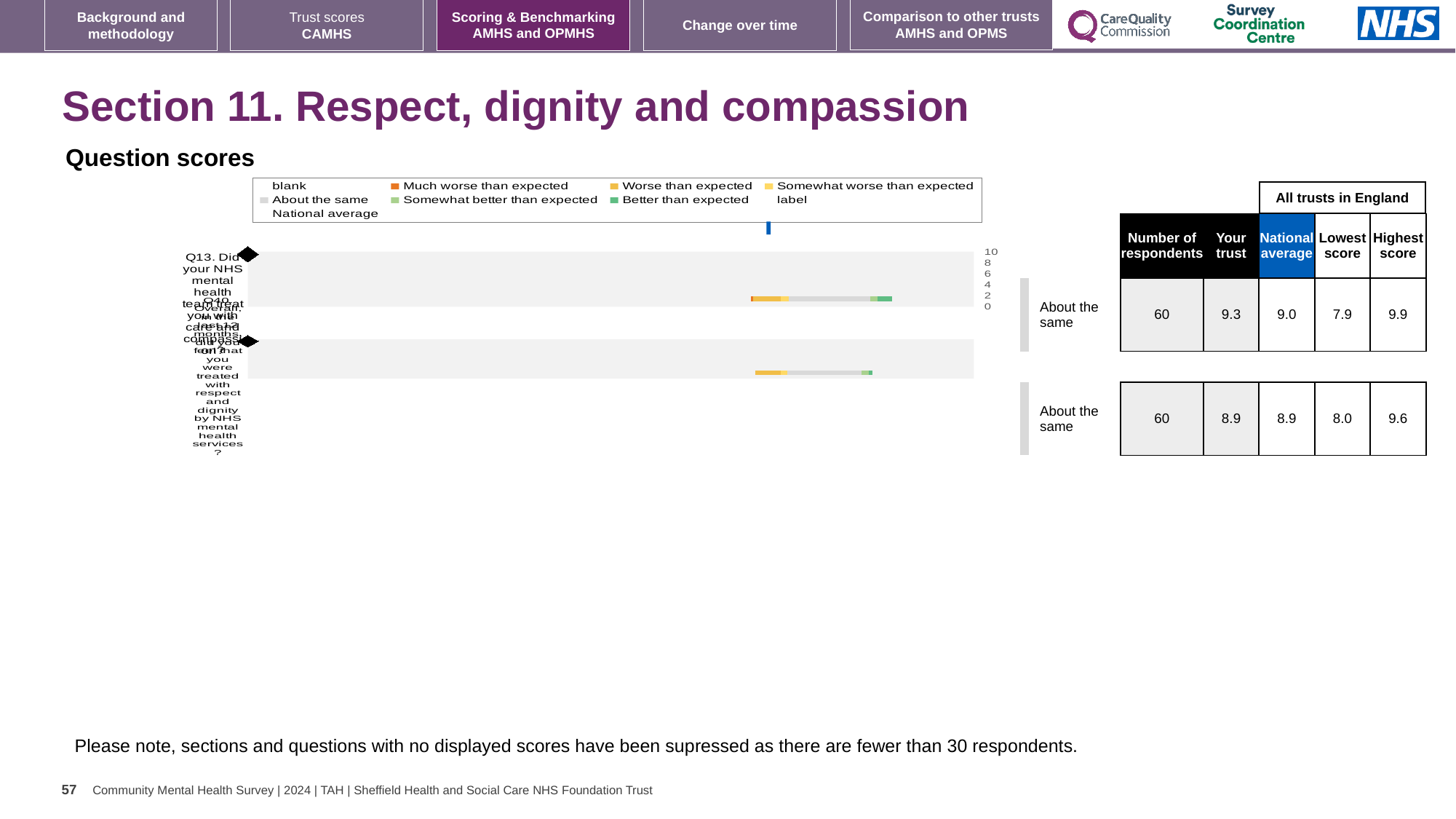
What benchmark category is shown beside both rows of the chart? About the same How many respondents are listed for the second (bottom) row of the table? 60 For the top row (Q13), what is the difference between the highest score and the lowest score? 2.0 For the top row (Q13), which is larger: the 'Your trust' score or the national average? Your trust In the table next to the chart, what is the national average for the top row (Q13)? 9.0 What kind of chart is used to show the question scores on this slide? bar chart What colour represents 'Better than expected' in the chart legend? green How many questions (rows) are plotted in the question scores chart? 2 What is the lowest score across all trusts in England for the top row (Q13)? 7.9 In the table next to the chart, what is the 'Your trust' score for the top row (Q13)? 9.3 What is the highest score across all trusts in England for the top row (Q13)? 9.9 What is the 'Your trust' score for the second (bottom) row of the table? 8.9